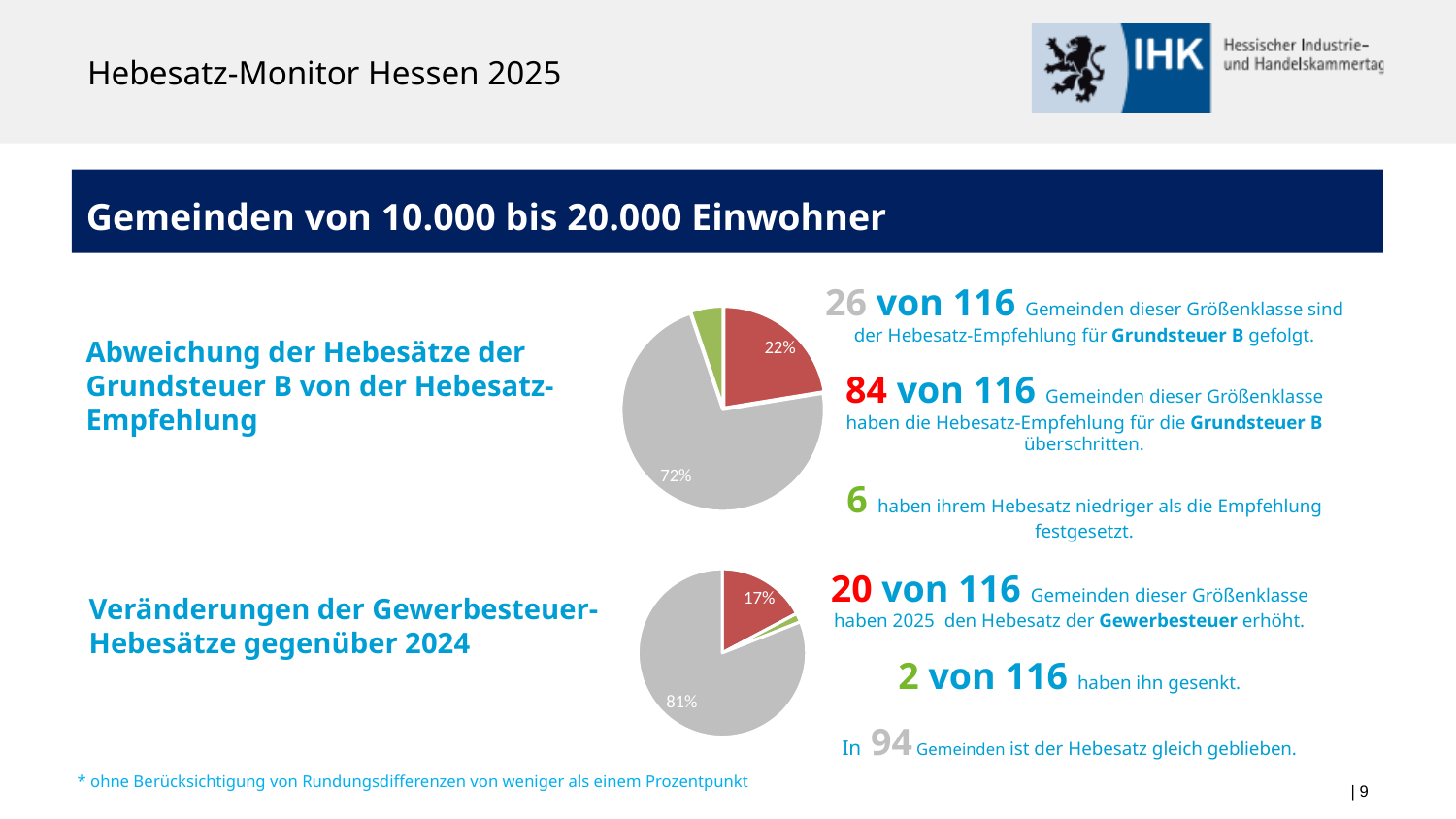
In the bottom pie chart (Veränderungen der Gewerbesteuer-Hebesätze gegenüber 2024), is the red slice or the grey slice larger? Grey In the top pie chart (Abweichung der Hebesätze der Grundsteuer B), what percentage is shown for the grey slice? 72% In the bottom pie chart (Veränderungen der Gewerbesteuer-Hebesätze gegenüber 2024), which colour slice is the smallest? Green In the top pie chart (Abweichung der Hebesätze der Grundsteuer B), which colour slice is the largest? Grey How many pie charts are shown on the slide? 2 In the top pie chart (Abweichung der Hebesätze der Grundsteuer B), what percentage is shown for the red slice? 22% In the bottom pie chart (Veränderungen der Gewerbesteuer-Hebesätze gegenüber 2024), what percentage is shown for the red slice? 17% In the top pie chart (Abweichung der Hebesätze der Grundsteuer B), what is the difference in percentage points between the grey slice and the red slice? 50 percentage points In the top pie chart (Abweichung der Hebesätze der Grundsteuer B), how many slices does the pie have? 3 In the bottom pie chart (Veränderungen der Gewerbesteuer-Hebesätze gegenüber 2024), what is the difference in percentage points between the grey slice and the red slice? 64 percentage points In the bottom pie chart (Veränderungen der Gewerbesteuer-Hebesätze gegenüber 2024), what percentage is shown for the grey slice? 81% What type of chart is used on this slide for the Grundsteuer B deviation and the Gewerbesteuer changes? Pie chart